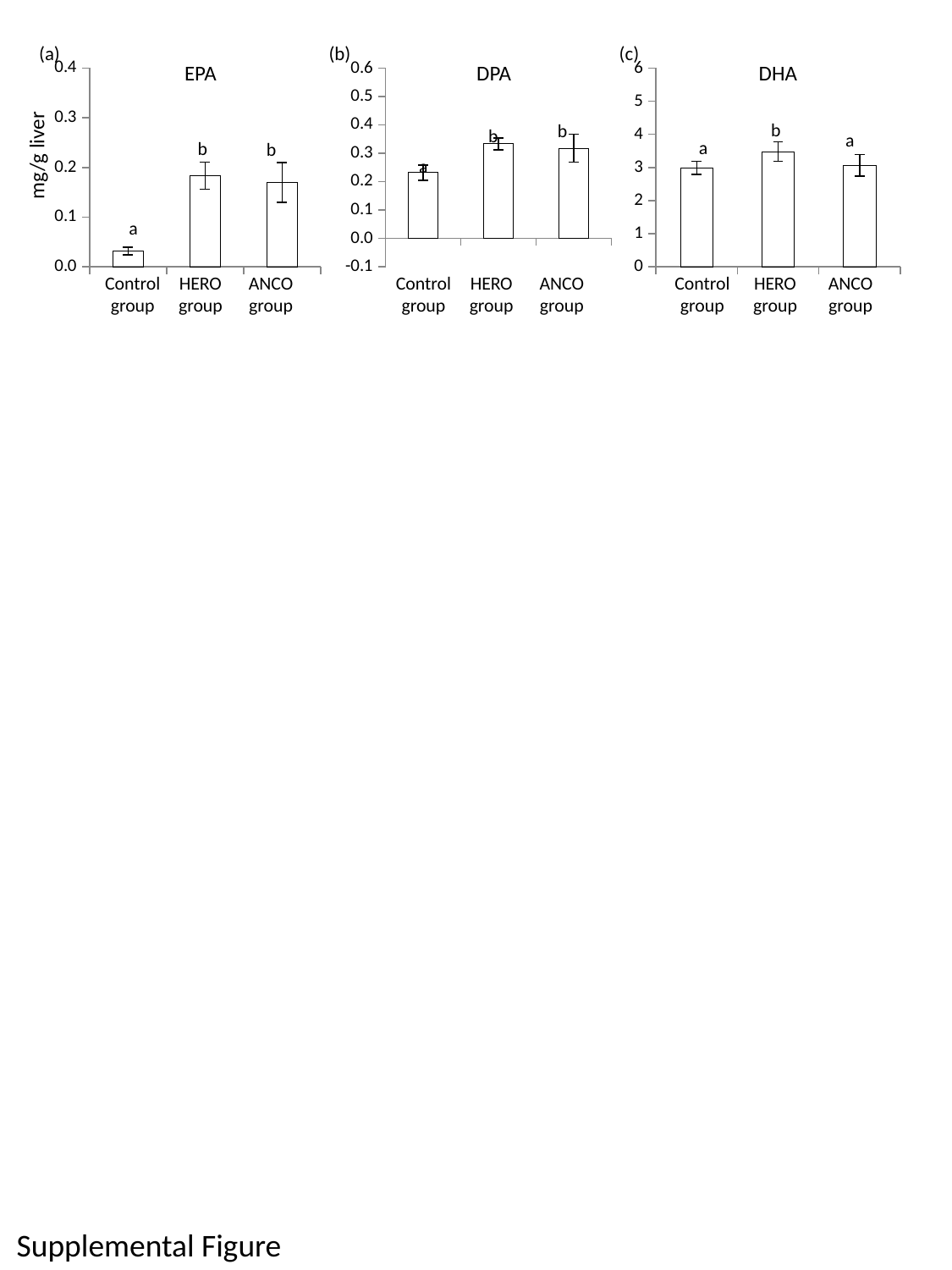
What is the y-axis label shown on the EPA chart? mg/g liver In the EPA chart, which group has the lowest value? Control group In the DHA chart, is the value for the Control group greater or less than 4? less In the DPA chart, is the value for the Control group greater or less than 0.3? less In the DHA chart, which group has the highest value? HERO group How many groups are shown in the DHA chart? 3 In the DPA chart, is the value for the HERO group greater or less than 0.3? greater In the DPA chart, which group has the lowest value? Control group What kind of chart is the EPA chart? bar chart In the EPA chart, which is larger, the value for the Control group or the HERO group? HERO group